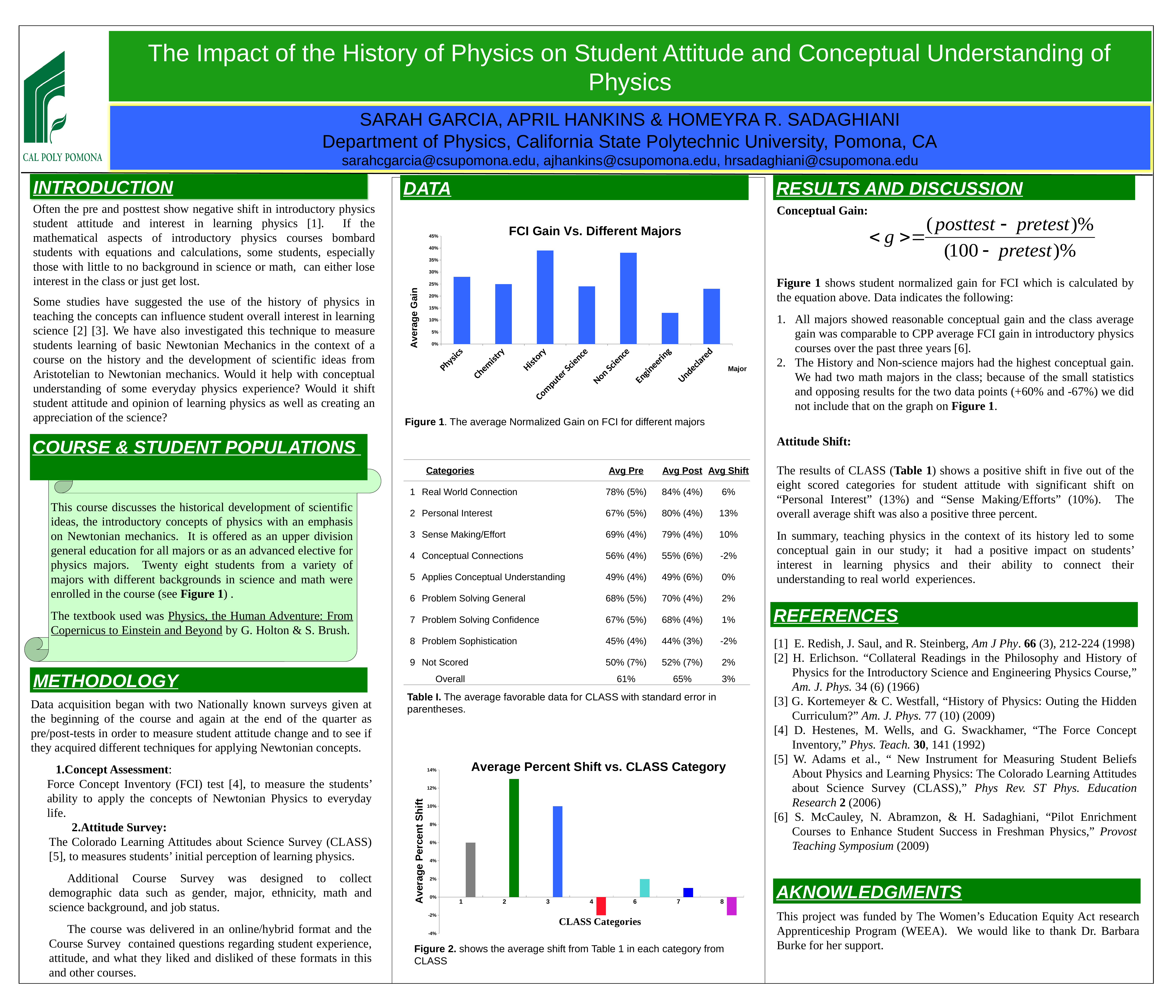
In the 'Average Percent Shift vs. CLASS Category' chart, what is the difference between the values for category 3 and category 1? 4% In the 'FCI Gain Vs. Different Majors' chart, how many majors are plotted? 7 In the 'FCI Gain Vs. Different Majors' chart, what is the label of the y axis? Average Gain In the 'Average Percent Shift vs. CLASS Category' chart, which category has the highest average percent shift? 2 In the 'FCI Gain Vs. Different Majors' chart, which major has the lowest average gain? Engineering In the 'Average Percent Shift vs. CLASS Category' chart, what is the average percent shift for category 3? 10% In the 'FCI Gain Vs. Different Majors' chart, is the value for Engineering greater or less than 15%? less In the 'FCI Gain Vs. Different Majors' chart, what kind of chart is shown? bar chart In the 'Average Percent Shift vs. CLASS Category' chart, what is the average percent shift for category 1? 6% In the 'FCI Gain Vs. Different Majors' chart, which is larger, the value for History or the value for Computer Science? History In the 'Average Percent Shift vs. CLASS Category' chart, is the value for category 2 greater or less than 12%? greater In the 'FCI Gain Vs. Different Majors' chart, is the value for History greater or less than 35%? greater